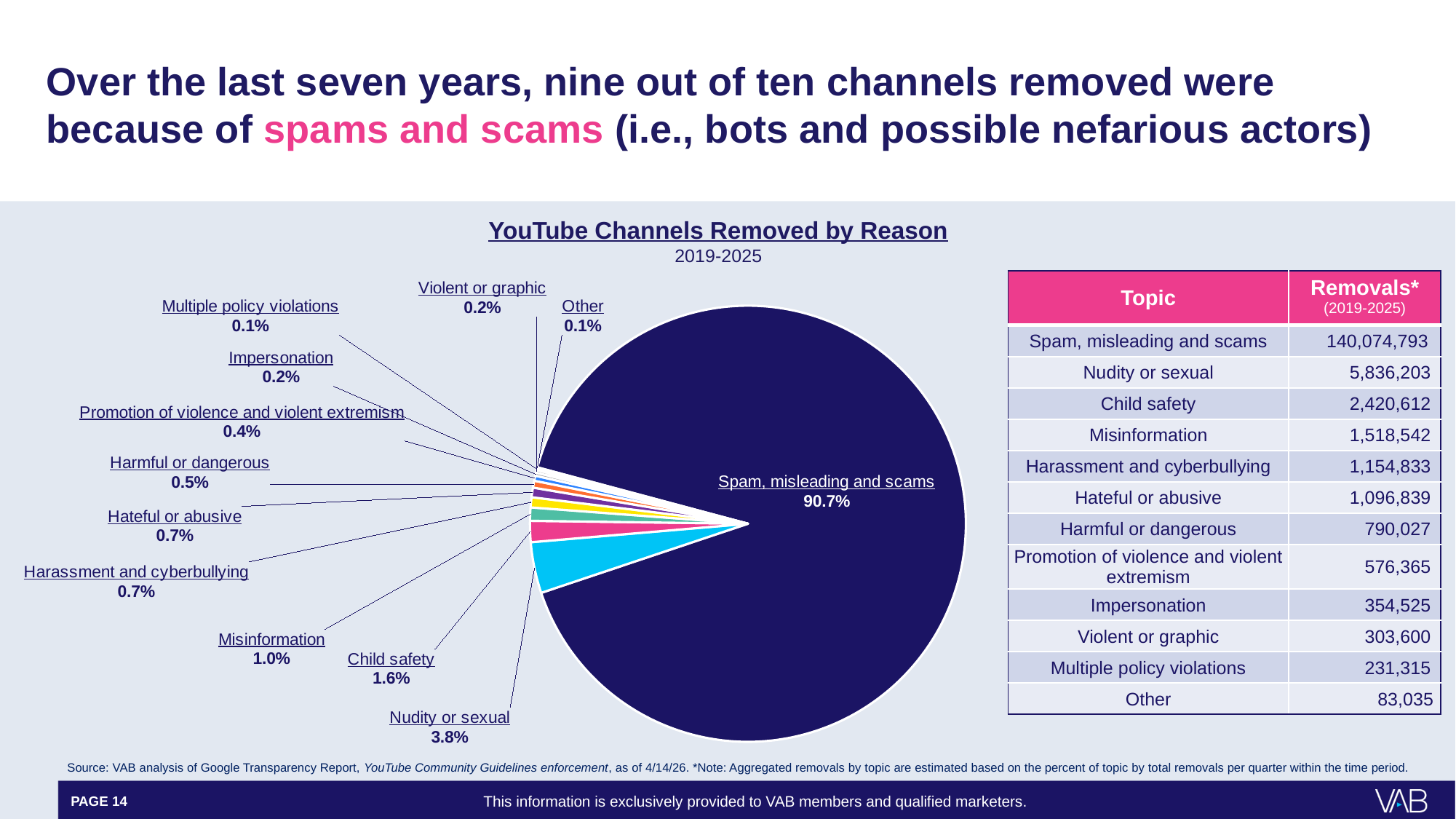
What is the difference in percentage points between Nudity or sexual and Child safety? 2.2% What share of the pie does Spam, misleading and scams account for? 90.7% What is the percentage shown for Nudity or sexual? 3.8% How many categories are shown in the pie chart? 12 What is the percentage shown for Misinformation? 1.0% Which category has the largest share of the pie? Spam, misleading and scams What time period does the chart cover, as shown in its subtitle? 2019-2025 What kind of chart is shown on the slide? Pie chart Which has a larger share, Harmful or dangerous or Promotion of violence and violent extremism? Harmful or dangerous What is the percentage shown for Child safety? 1.6% Which category has the smallest share of the pie? Other What is the title of the chart? YouTube Channels Removed by Reason